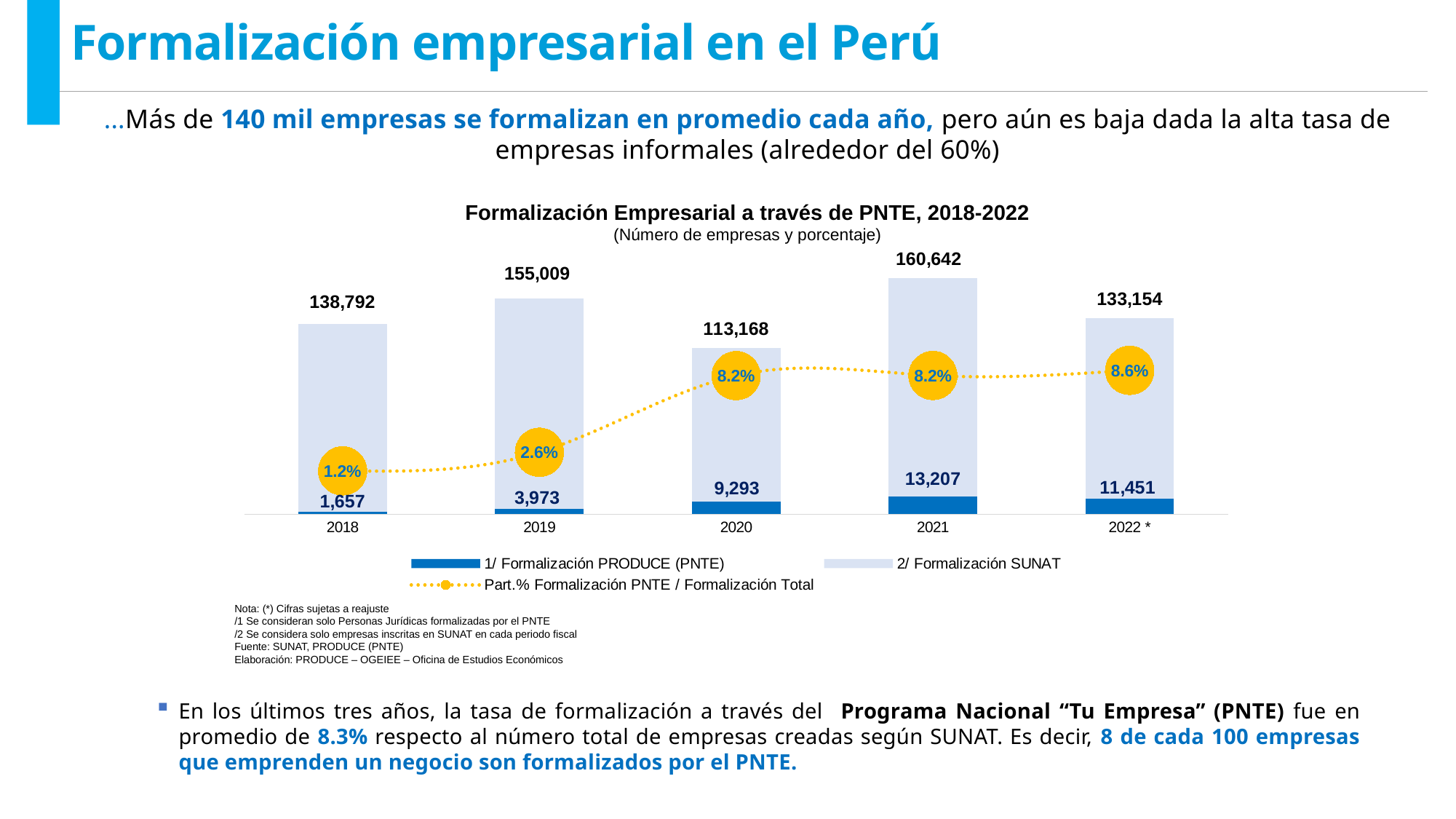
What is the difference between the 2/ Formalización SUNAT values for 2019 and 2020? 41,841 How many series does the legend list? 3 Which year has the highest value for 2/ Formalización SUNAT? 2021 Which year has the lowest value for 1/ Formalización PRODUCE (PNTE)? 2018 What is the value of 2/ Formalización SUNAT for 2021? 160,642 Which is larger, the 1/ Formalización PRODUCE (PNTE) value for 2021 or for 2022 *? 2021 What is the Part.% Formalización PNTE / Formalización Total for 2019? 2.6% What is the value of 1/ Formalización PRODUCE (PNTE) for 2020? 9,293 How many years are shown on the x axis of the chart? 5 What kind of chart is used to show the Formalización SUNAT and Formalización PRODUCE (PNTE) values? Bar chart What is the title of the chart? Formalización Empresarial a través de PNTE, 2018-2022 Does the Part.% Formalización PNTE / Formalización Total rise or fall from 2018 to 2020? Rise